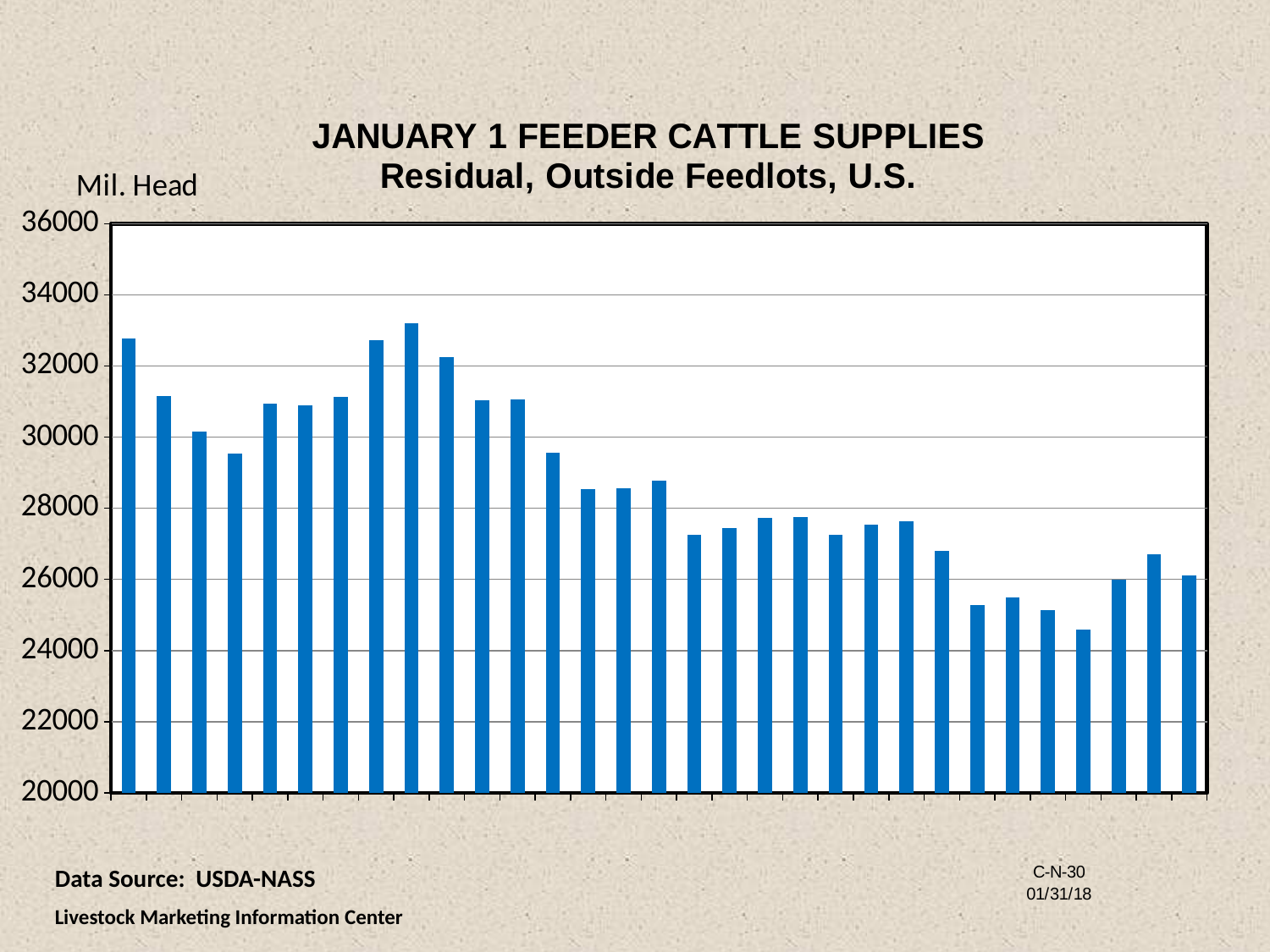
What unit label is shown above the vertical axis? Mil. Head Which is larger, the first bar on the left or the last bar on the right? the first bar on the left Is the value of the tallest bar greater or less than 32000? greater Is the value of the shortest bar greater or less than 26000? less Overall, do the bar values rise or fall from left to right across the chart? fall Is the value of the last (rightmost) bar greater or less than 28000? less What kind of chart is shown on the slide? bar chart What is the lowest value shown on the vertical axis? 20000 What is the title of the chart? JANUARY 1 FEEDER CATTLE SUPPLIES Residual, Outside Feedlots, U.S. Is the tallest bar located in the left half or the right half of the chart? left half Is the shortest bar located in the left half or the right half of the chart? right half